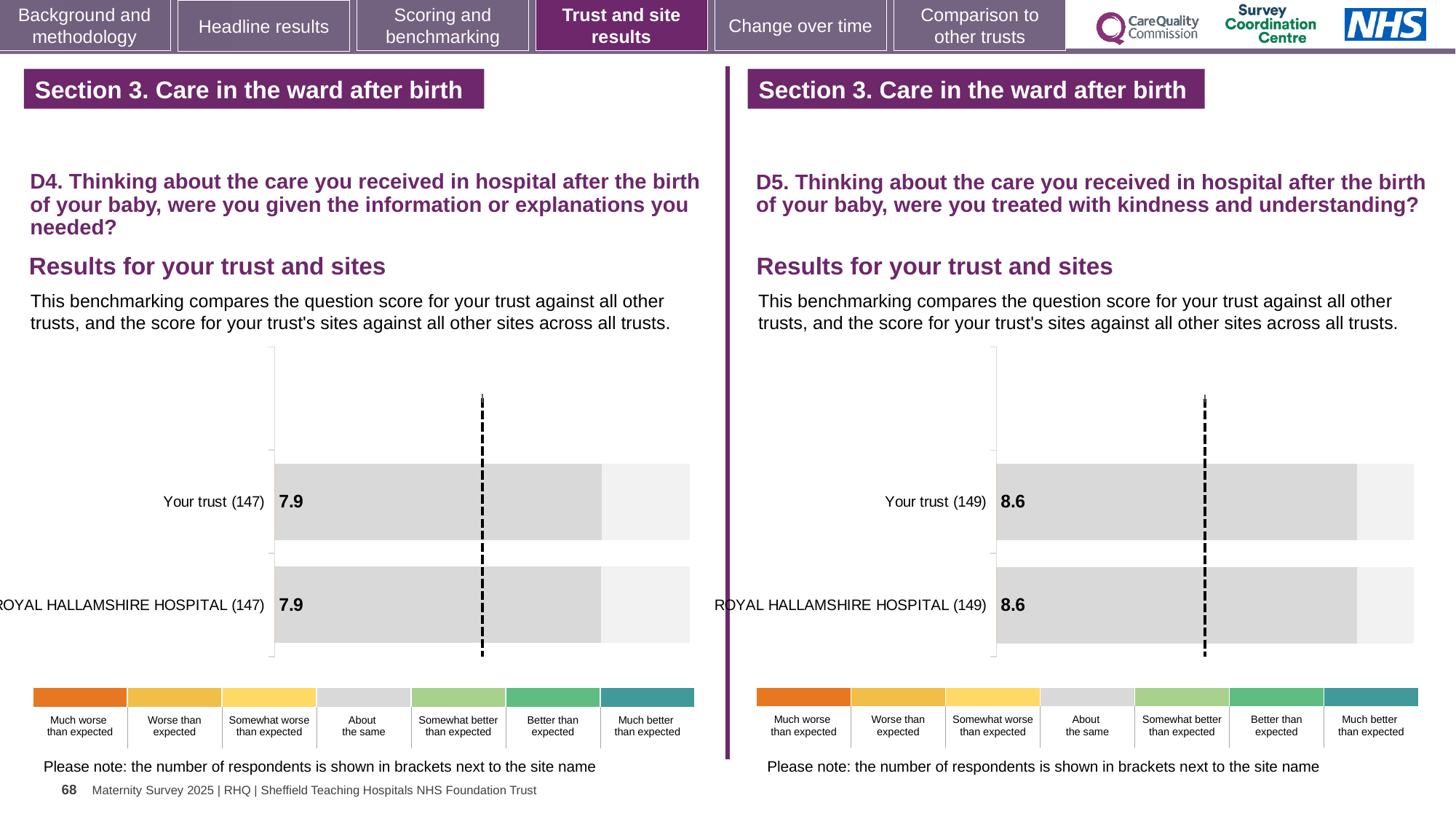
On the D4 chart (left), what is the score for ROYAL HALLAMSHIRE HOSPITAL? 7.9 On the D5 chart (right), how many respondents are shown in brackets next to Your trust? 149 What kind of chart is the D5 chart (right)? bar chart How many rating categories does the colour legend below the D4 chart (left) list? 7 In the legend below the D5 chart (right), what colour represents 'Much worse than expected'? orange How many bars are plotted on the D4 chart (left)? 2 On the D5 chart (right), what is the score for ROYAL HALLAMSHIRE HOSPITAL? 8.6 Is the score for Your trust on the D5 chart (right) larger or smaller than the score for Your trust on the D4 chart (left)? larger On the D5 chart (right), what is the score for Your trust? 8.6 What is the difference between the Your trust score on the D5 chart (right) and the Your trust score on the D4 chart (left)? 0.7 On the D4 chart (left), what is the score for Your trust? 7.9 On the D4 chart (left), what is the difference between the score for Your trust and the score for ROYAL HALLAMSHIRE HOSPITAL? 0